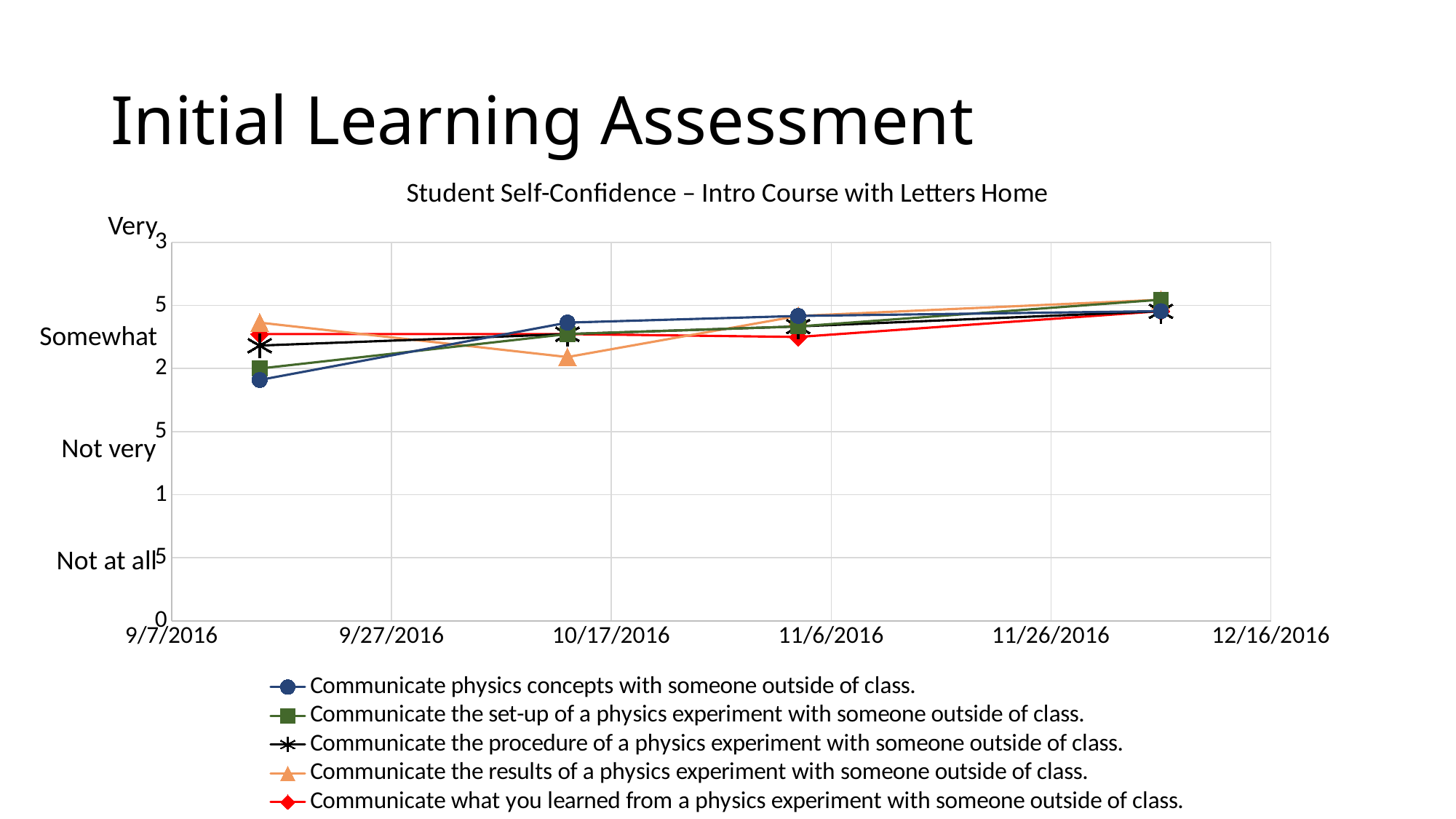
Which series has the lowest value at the second date (mid-October)? Communicate the results of a physics experiment with someone outside of class. Is the first value for 'Communicate physics concepts with someone outside of class.' greater or less than 2? less Is the first value for 'Communicate what you learned from a physics experiment with someone outside of class.' greater or less than 2? greater Which series has the lowest value at the first date? Communicate physics concepts with someone outside of class. What kind of chart is shown on the slide? line chart Which series is plotted with asterisk (star) markers? Communicate the procedure of a physics experiment with someone outside of class. What is the title of the chart? Student Self-Confidence – Intro Course with Letters Home Is the first value for 'Communicate the results of a physics experiment with someone outside of class.' greater or less than 2? greater How many data points does each series have? 4 At the first date, which is higher: 'Communicate the results of a physics experiment with someone outside of class.' or 'Communicate physics concepts with someone outside of class.'? Communicate the results of a physics experiment with someone outside of class. Do the values for 'Communicate physics concepts with someone outside of class.' rise or fall from the first date to the last? rise How many series does the legend list? 5